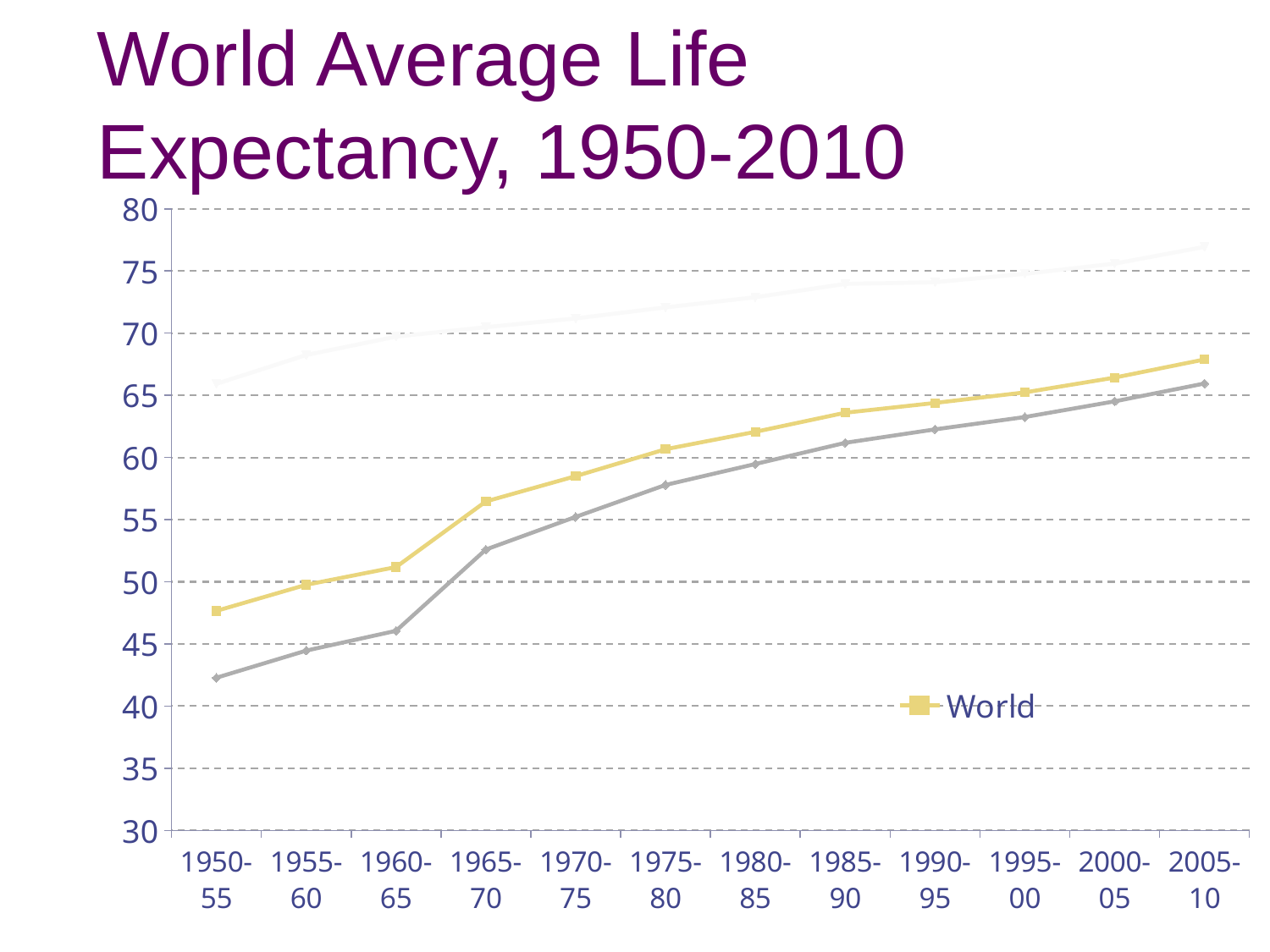
How many series does the legend list? 1 How many time periods are shown along the x axis? 12 Is the World value for 1950-55 greater or less than 50? less What is the title of the chart? World Average Life Expectancy, 1950-2010 In which period is the World value highest? 2005-10 What kind of chart is shown on the slide? line chart What series name appears in the legend? World Does the World line rise or fall from 1950-55 to 2005-10? rise In which period is the World value lowest? 1950-55 Is the World value for 2005-10 greater or less than 65? greater Is the World value for 1970-75 greater or less than 60? less